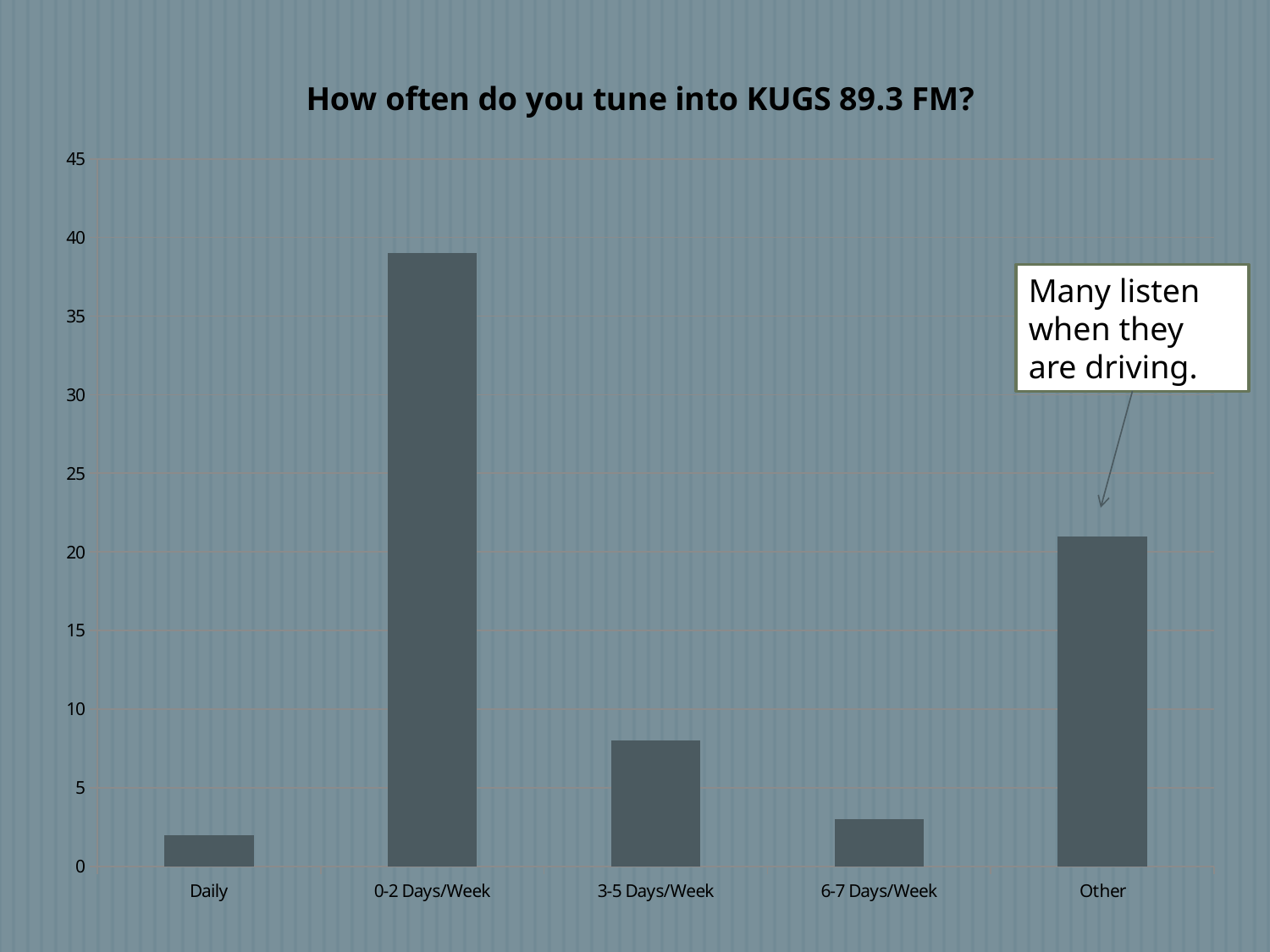
Is the value for Other greater or less than 25? less Is the value for 0-2 Days/Week greater or less than 35? greater Which category has the lowest value? Daily What does the callout box pointing to the Other bar say? Many listen when they are driving. Is the value for 6-7 Days/Week greater or less than 5? less Which is larger, the value for Other or the value for 3-5 Days/Week? Other What is the title of the chart? How often do you tune into KUGS 89.3 FM? What kind of chart is shown on the slide? bar chart How many categories are shown on the x axis? 5 Which is larger, the value for 0-2 Days/Week or the value for Other? 0-2 Days/Week Which category has the highest value? 0-2 Days/Week